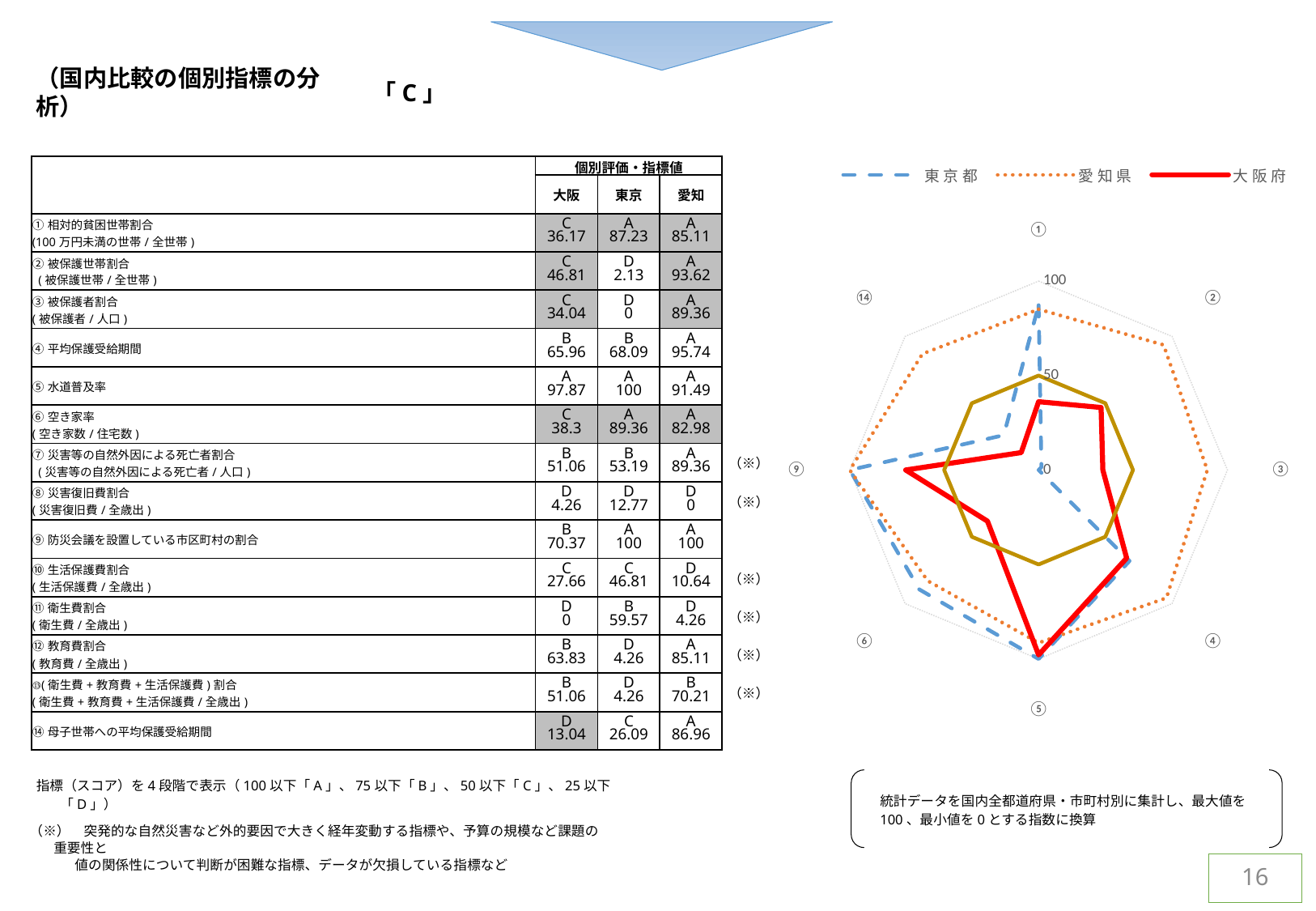
In the radar chart, is the value for 大阪府 on axis ⑥ greater or less than 50? less In the radar chart, what is the value for 東京都 on axis ⑤? 100 What kind of chart is shown on the right side of the slide? radar chart In the radar chart, is the value for 愛知県 on axis ③ greater or less than 50? greater How many series does the legend of the radar chart list? 3 What is the highest value shown on the radar chart's axis scale? 100 In the radar chart, is the value for 東京都 on axis ① greater or less than 50? greater In the radar chart, what is the value for 東京都 on axis ⑨? 100 In the radar chart, which series has the larger value on axis ①, 東京都 or 大阪府? 東京都 Which series in the radar chart is drawn with a solid red line? 大阪府 In the radar chart, what is the value for 東京都 on axis ③? 0